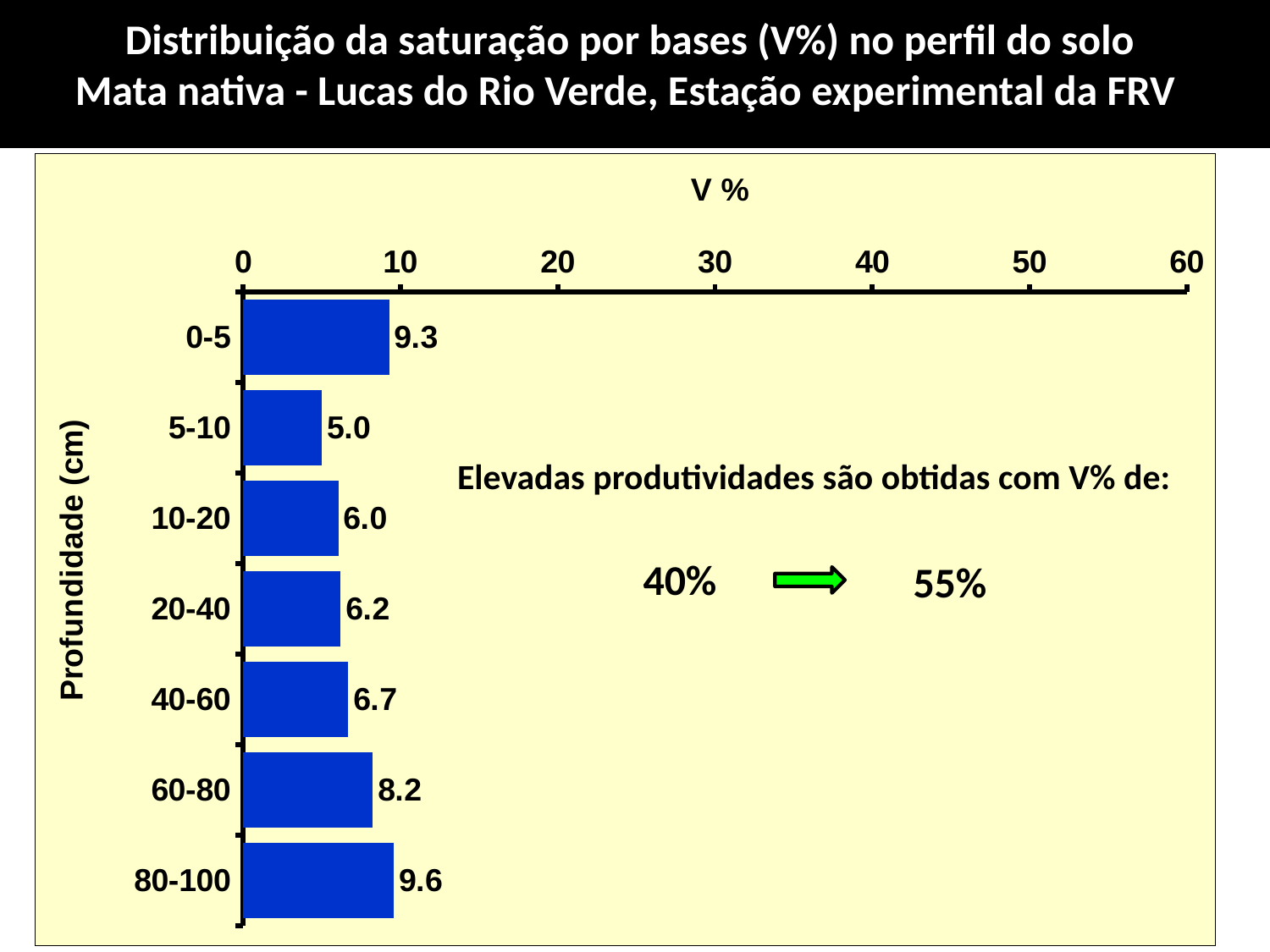
How many depth categories are shown in the chart? 7 What is the V% value for the 40-60 cm depth? 6.7 What is the V% value for the 80-100 cm depth? 9.6 Which has a larger V% value, the 60-80 cm depth or the 20-40 cm depth? 60-80 Is the V% value for the 0-5 cm depth greater or less than 10? less What is the V% value for the 5-10 cm depth? 5.0 What is the difference between the V% values for 80-100 cm and 5-10 cm? 4.6 What is the label of the vertical axis of the chart? Profundidade (cm) What is the V% value for the 0-5 cm depth? 9.3 Which depth has the highest V% value? 80-100 Which depth has the lowest V% value? 5-10 What kind of chart is shown on the slide? bar chart